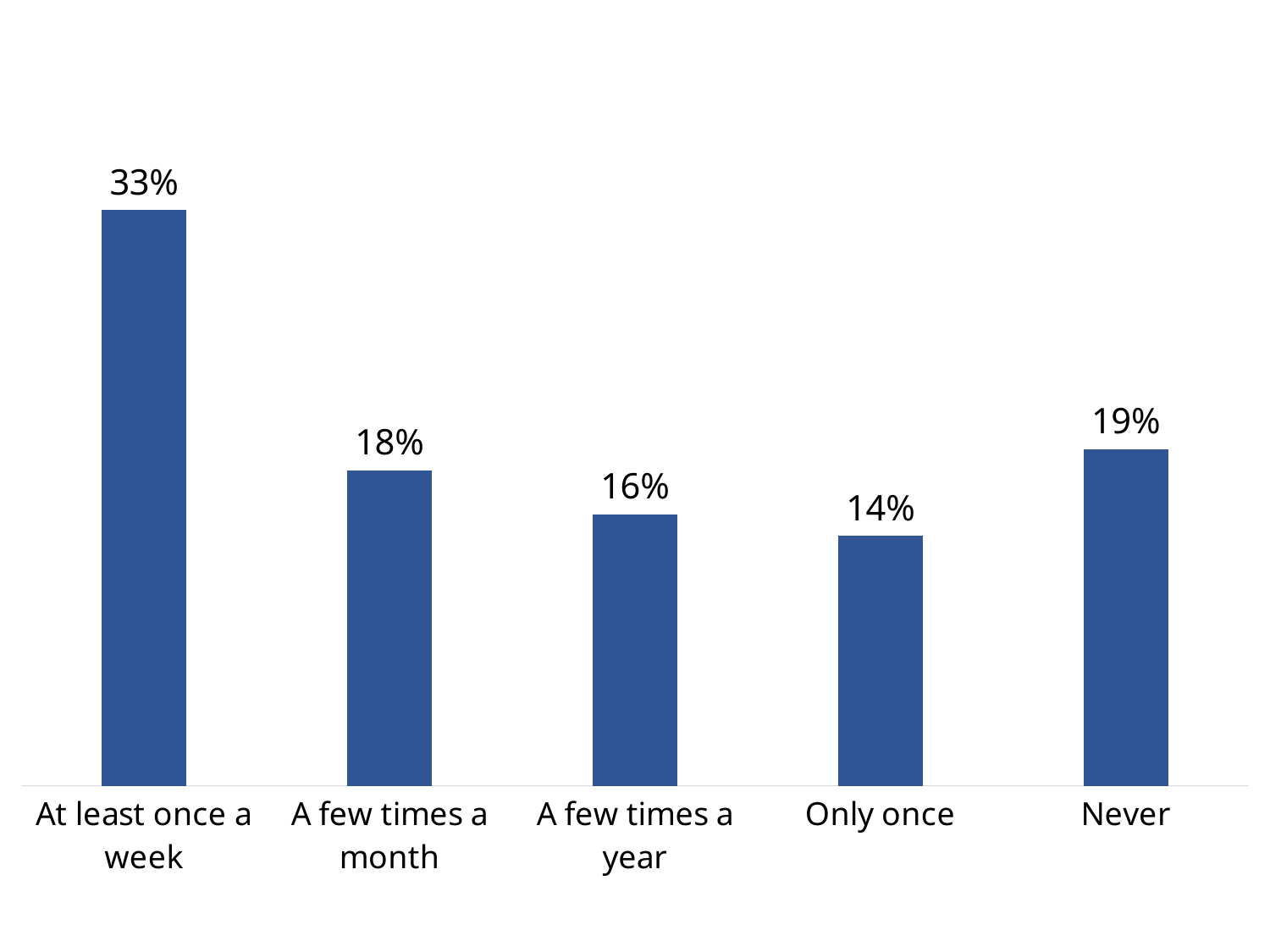
What is the difference between the values for "At least once a week" and "Never"? 14% How many categories are shown on the x axis? 5 What is the value for "Only once"? 14% What is the value for "Never"? 19% What is the value for "A few times a month"? 18% What is the value for "At least once a week"? 33% What kind of chart is shown on the slide? Bar chart Which category has the highest value? At least once a week What is the difference between the values for "A few times a month" and "Only once"? 4% Which is larger, the value for "Never" or the value for "A few times a year"? Never Which category has the lowest value? Only once What is the value for "A few times a year"? 16%